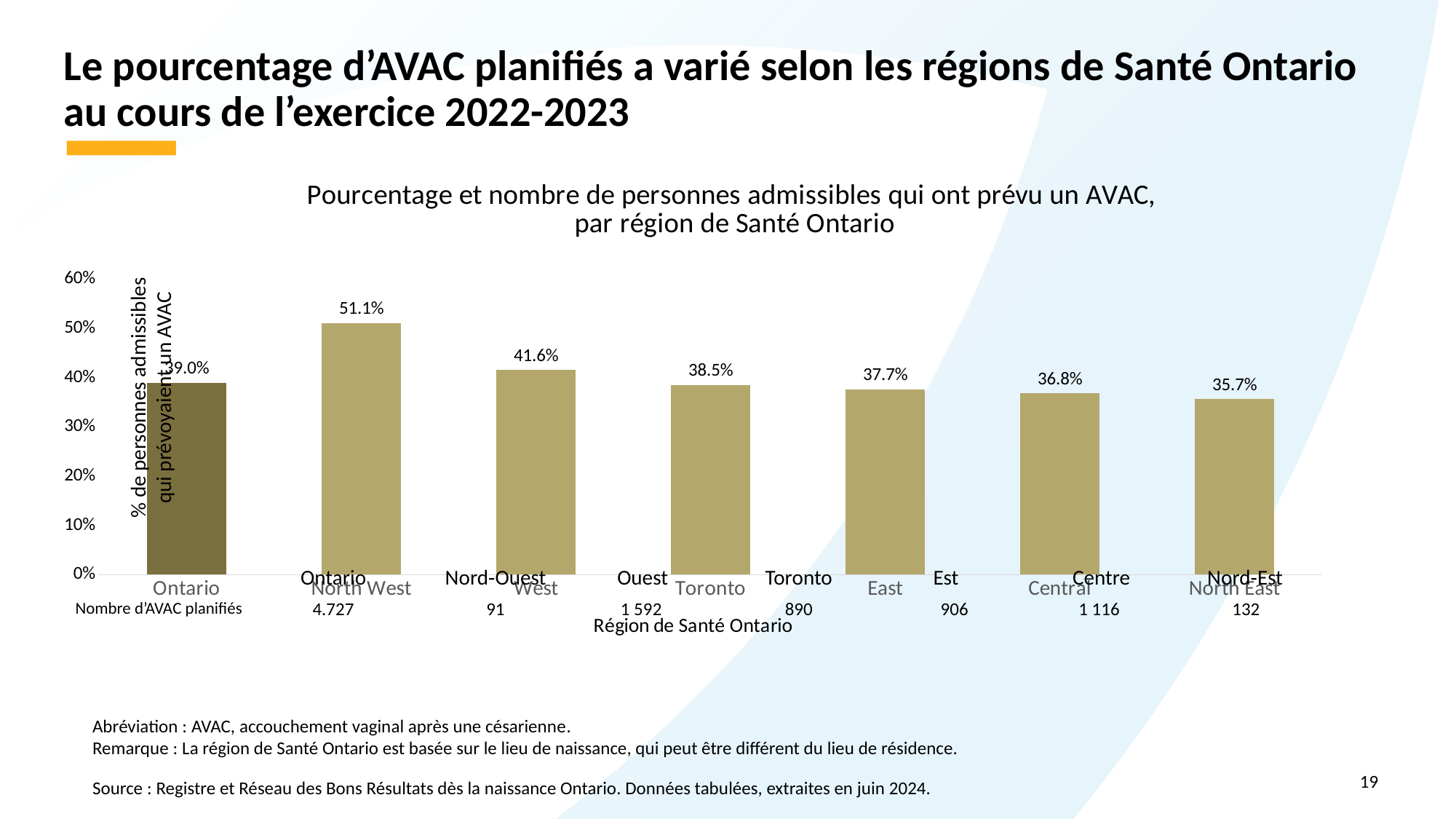
What is the number of planned VBACs (Nombre d'AVAC planifiés) shown for the Nord-Ouest (North West) region? 91 Which region has the highest percentage of planned VBACs (AVAC)? Nord-Ouest (North West) What is the percentage value shown for the Centre (Central) region? 36.8% Which has a higher percentage of planned VBACs: Ouest (West) or Est (East)? Ouest (West) Which region has the lowest percentage of planned VBACs (AVAC)? Nord-Est (North East) What is the percentage of eligible people who planned a VBAC (AVAC) in the Nord-Ouest (North West) region? 51.1% What is the title of the chart? Pourcentage et nombre de personnes admissibles qui ont prévu un AVAC, par région de Santé Ontario What is the difference in percentage points between the Nord-Ouest (North West) region and Ontario overall? 12.1 percentage points What is the percentage value shown for Toronto? 38.5% How many regions/categories are plotted on the chart? 7 What type of chart is shown on the slide? Bar chart What is the number of planned VBACs (Nombre d'AVAC planifiés) shown for the Ouest (West) region? 1 592